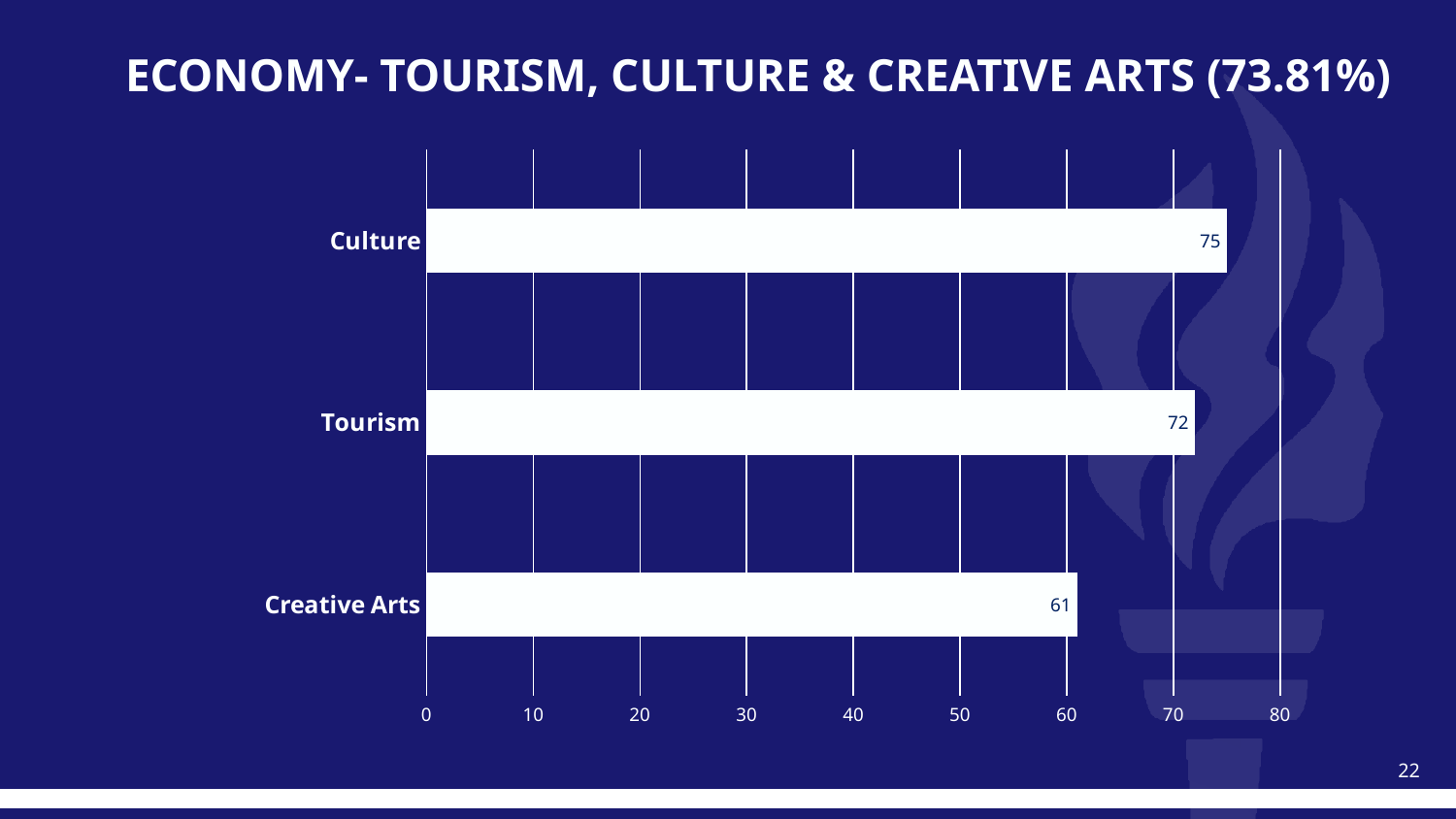
What is the title of the slide? ECONOMY- TOURISM, CULTURE & CREATIVE ARTS (73.81%) Which category has the lowest value? Creative Arts What is the value for Tourism? 72 How many categories are shown in the chart? 3 What is the value for Creative Arts? 61 What kind of chart is shown on the slide? bar chart Which category has the highest value? Culture What is the value for Culture? 75 Which is larger, the value for Tourism or the value for Creative Arts? Tourism Is the value for Creative Arts greater or less than 70? less What is the difference between the values for Culture and Creative Arts? 14 What is the difference between the values for Tourism and Creative Arts? 11